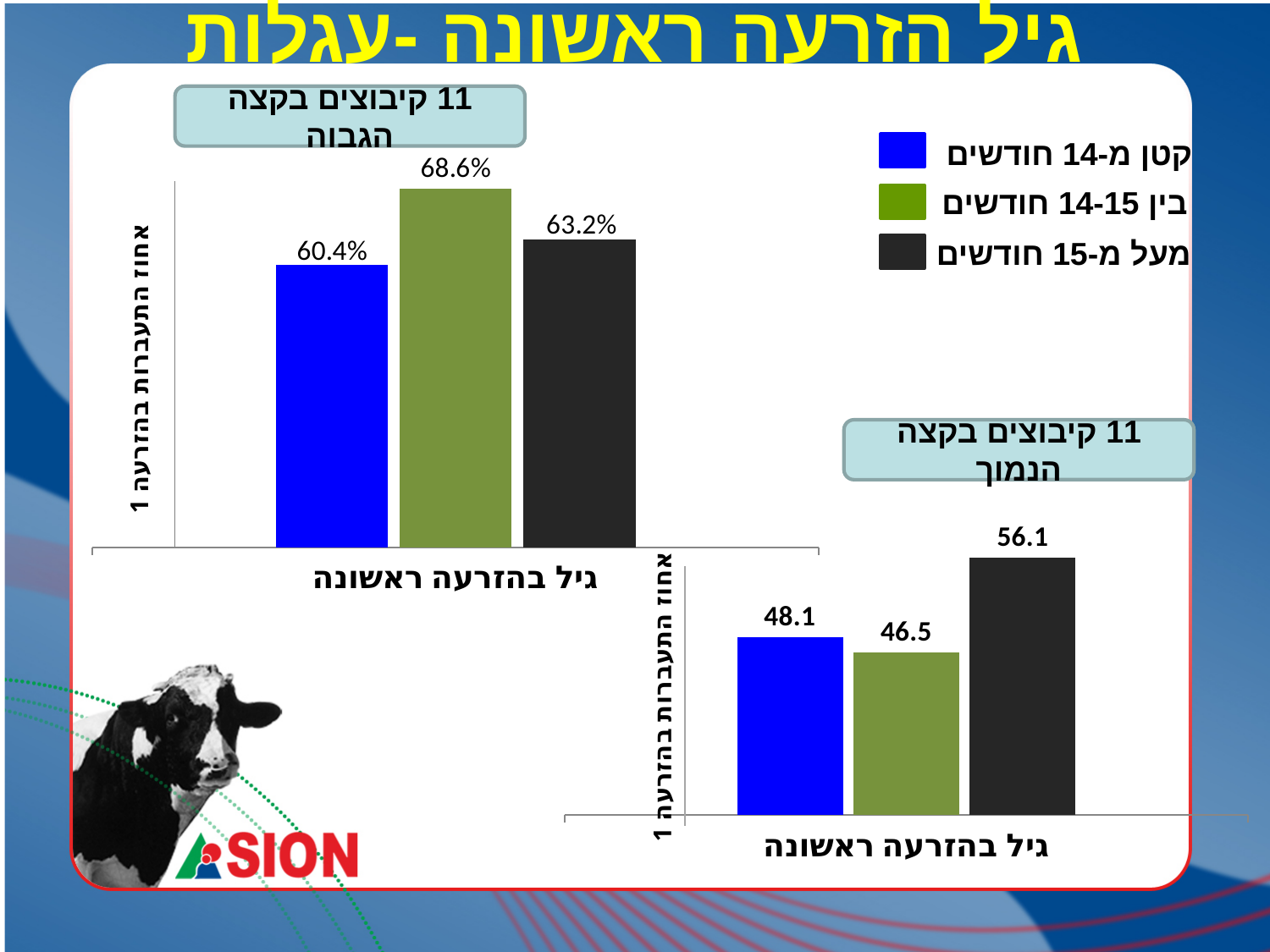
In the top-left chart (11 קיבוצים בקצה הגבוה), which series has the highest value? בין 14-15 חודשים In the top-left chart (11 קיבוצים בקצה הגבוה), what is the value for the black series (מעל מ-15 חודשים)? 63.2% In the top-left chart (11 קיבוצים בקצה הגבוה), what is the value for the green series (בין 14-15 חודשים)? 68.6% In the bottom-right chart (11 קיבוצים בקצה הנמוך), what is the value for the black series (מעל מ-15 חודשים)? 56.1 In the bottom-right chart (11 קיבוצים בקצה הנמוך), which series has the lowest value? בין 14-15 חודשים In the bottom-right chart (11 קיבוצים בקצה הנמוך), what is the difference between the black series (56.1) and the green series (46.5)? 9.6 In the top-left chart (11 קיבוצים בקצה הגבוה), what is the value for the blue series (קטן מ-14 חודשים)? 60.4% In the bottom-right chart (11 קיבוצים בקצה הנמוך), what is the value for the blue series (קטן מ-14 חודשים)? 48.1 In the bottom-right chart (11 קיבוצים בקצה הנמוך), which is larger: the blue series (קטן מ-14 חודשים) or the green series (בין 14-15 חודשים)? קטן מ-14 חודשים What kind of chart is the top-left chart (11 קיבוצים בקצה הגבוה)? Bar chart In the top-left chart (11 קיבוצים בקצה הגבוה), what is the difference between the green series (68.6%) and the blue series (60.4%)? 8.2% How many series does the legend on the slide list? 3